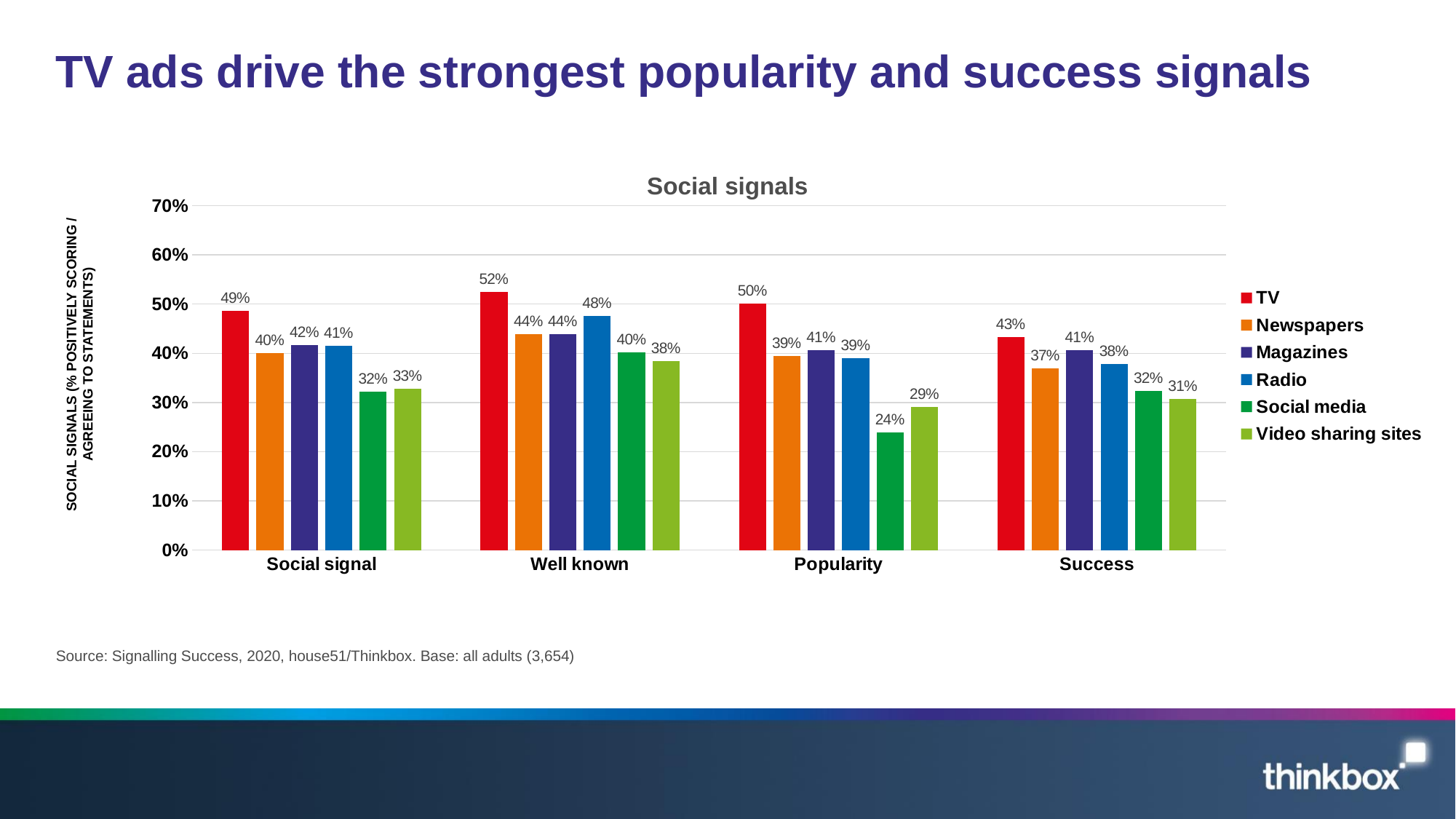
Which series has the highest value in the Popularity category? TV How many series does the legend list? 6 Which is larger in the Social signal category: Radio or Social media? Radio What is the title of the chart? Social signals What kind of chart is shown on the slide? Bar chart What is the value for Newspapers in the Success category? 37% Which series has the lowest value in the Success category? Video sharing sites How many categories are shown on the x axis? 4 What is the value for TV in the Well known category? 52% What is the difference between the TV value and the Social media value in the Popularity category? 26% What is the value for Social media in the Popularity category? 24% Is the value for TV in the Social signal category greater or less than 40%? greater